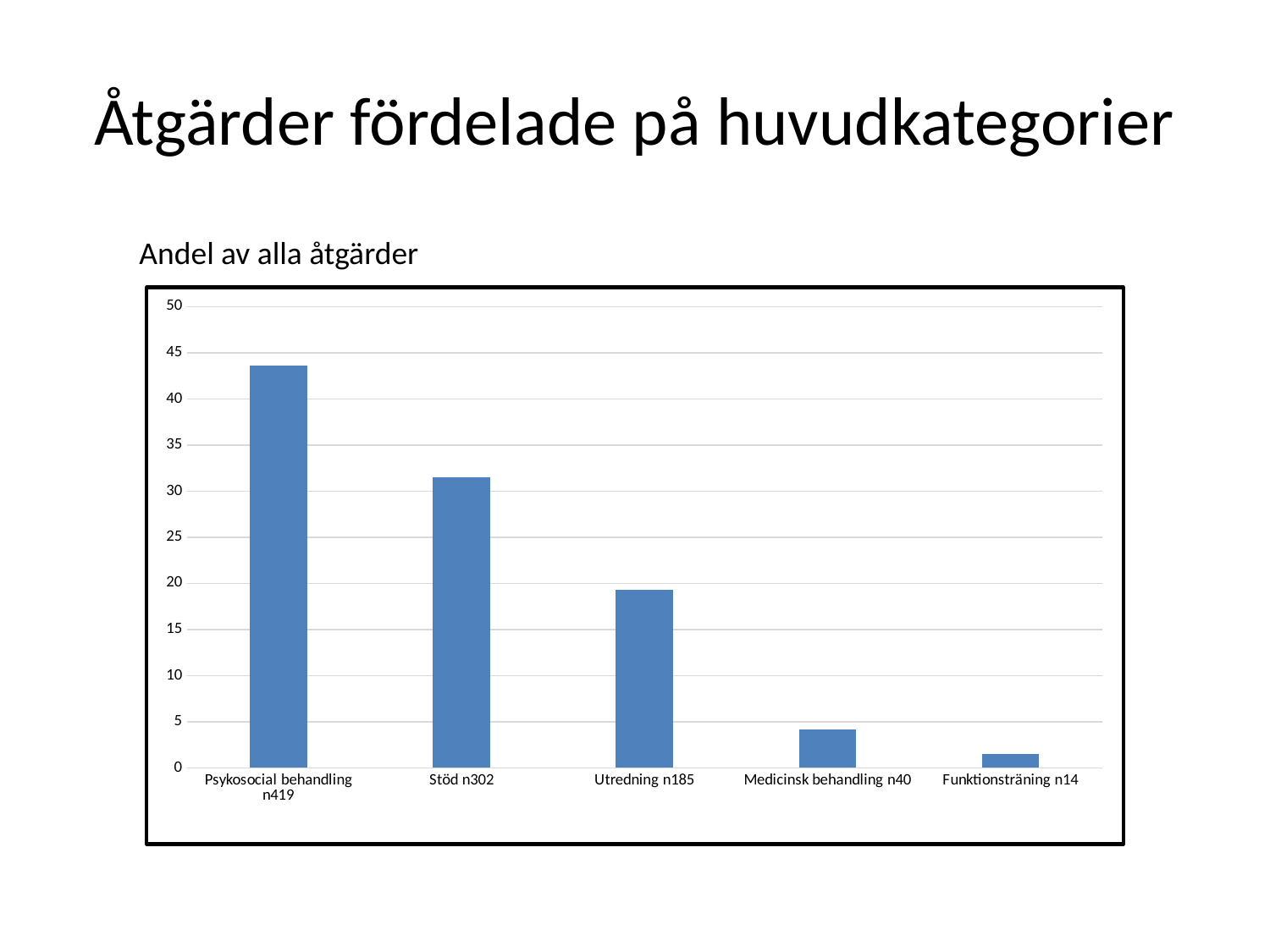
Is the value for Stöd n302 greater or less than 30? greater What is the maximum value shown on the y axis of the chart? 50 Which category has the highest value in the chart? Psykosocial behandling n419 Do the values rise or fall from left to right along the x axis? fall Which is larger, the value for Stöd n302 or the value for Utredning n185? Stöd n302 What kind of chart is shown on the slide? bar chart How many categories are shown on the x axis of the chart? 5 What is the title of the chart? Andel av alla åtgärder Which category has the lowest value in the chart? Funktionsträning n14 Is the value for Utredning n185 greater or less than 20? less Is the value for Medicinsk behandling n40 greater or less than 5? less